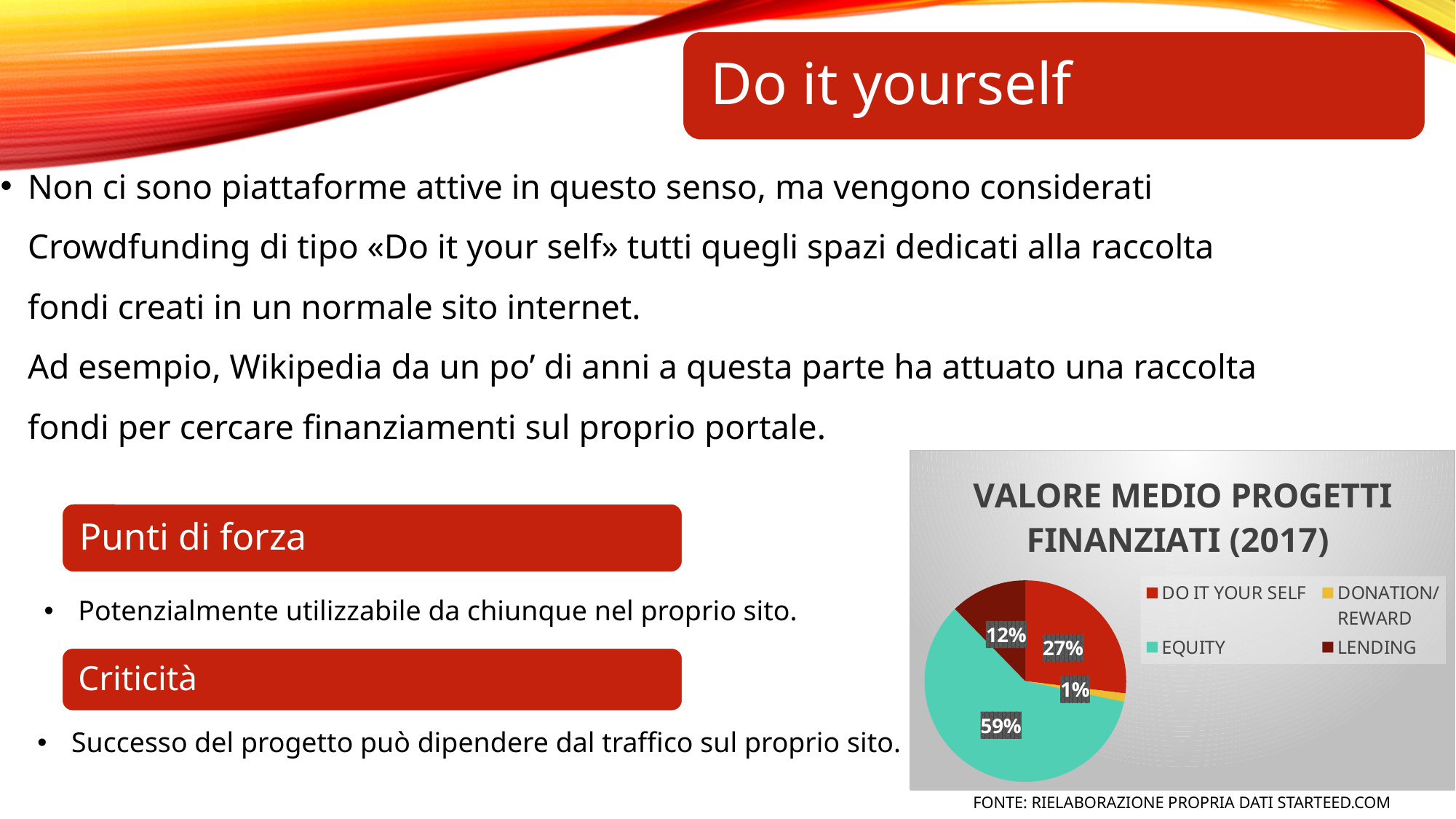
What is the title of the chart on the slide? VALORE MEDIO PROGETTI FINANZIATI (2017) What colour is the EQUITY slice in the pie chart? Teal Which is larger, the share for DO IT YOUR SELF or the share for LENDING? DO IT YOUR SELF What is the difference in percentage points between EQUITY and DO IT YOUR SELF? 32 Which category has the smallest slice of the pie? DONATION/REWARD What share of the pie does DO IT YOUR SELF hold? 27% What share of the pie does DONATION/REWARD hold? 1% What kind of chart is shown on the slide? Pie chart What share of the pie does EQUITY hold? 59% How many categories does the pie chart show? 4 Which category has the largest slice of the pie? EQUITY